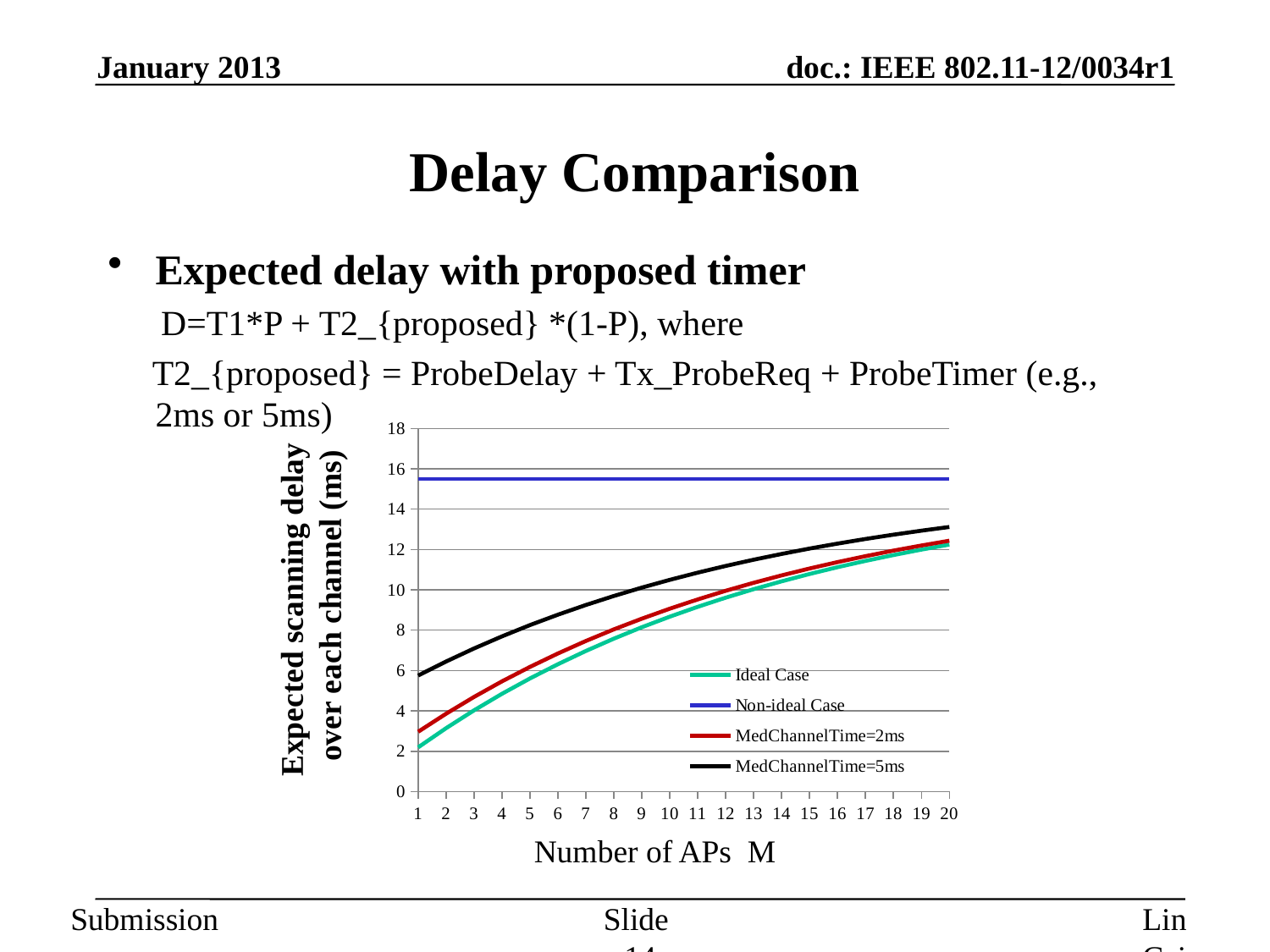
Is the value for MedChannelTime=5ms at M=20 greater or less than 12? greater How many series does the chart legend list? 4 Does the Ideal Case series rise or fall as the number of APs M increases? rises Does the Non-ideal Case series rise, fall, or stay flat as the number of APs M increases? stays flat Which series has the highest value at M=1? Non-ideal Case Is the value for MedChannelTime=5ms at M=1 greater or less than 4? greater What kind of chart is shown on the slide? line chart At M=5, which is larger: MedChannelTime=5ms or Ideal Case? MedChannelTime=5ms Is the value for Non-ideal Case at M=10 greater or less than 14? greater How many values of M (Number of APs) are shown along the x axis? 20 Which series has the lowest value at M=1? Ideal Case